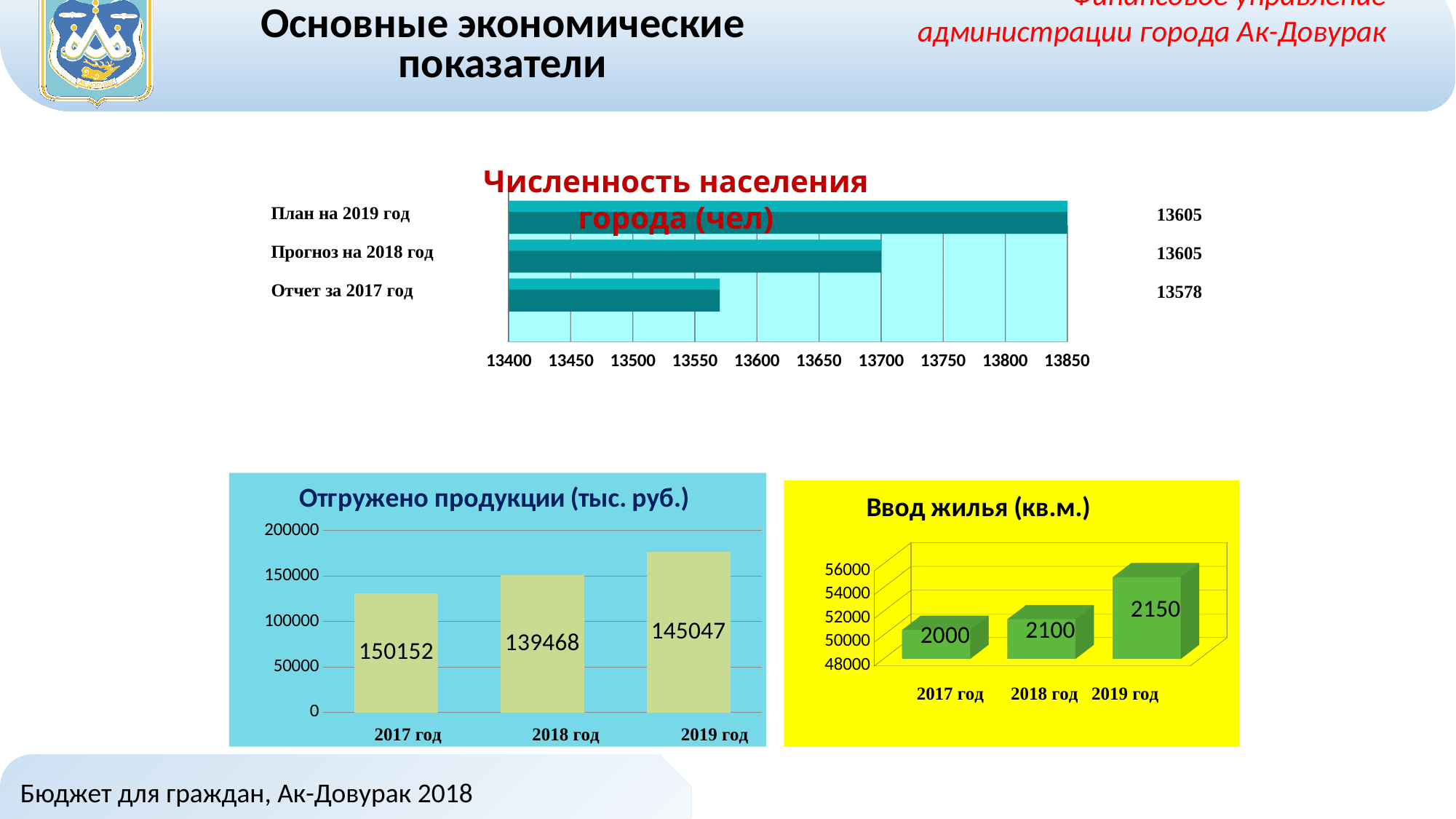
In the chart 'Отгружено продукции (тыс. руб.)', what is the value for '2018 год'? 139468 In the chart 'Численность населения города (чел)', what is the difference between the value for 'План на 2019 год' and the value for 'Отчет за 2017 год'? 27 How many categories are shown in the chart 'Численность населения города (чел)'? 3 In the chart 'Ввод жилья (кв.м.)', which year has the highest value? 2019 год In the chart 'Ввод жилья (кв.м.)', do the values rise or fall from 2017 год to 2019 год? rise In the chart 'Численность населения города (чел)', what is the value for 'План на 2019 год'? 13605 What kind of chart is 'Численность населения города (чел)'? bar chart In the chart 'Численность населения города (чел)', what is the value for 'Отчет за 2017 год'? 13578 In the chart 'Ввод жилья (кв.м.)', what is the difference between the values for '2019 год' and '2017 год'? 150 In the chart 'Отгружено продукции (тыс. руб.)', what is the value for '2019 год'? 145047 In the chart 'Отгружено продукции (тыс. руб.)', what is the value for '2017 год'? 150152 In the chart 'Ввод жилья (кв.м.)', what is the value for '2018 год'? 2100